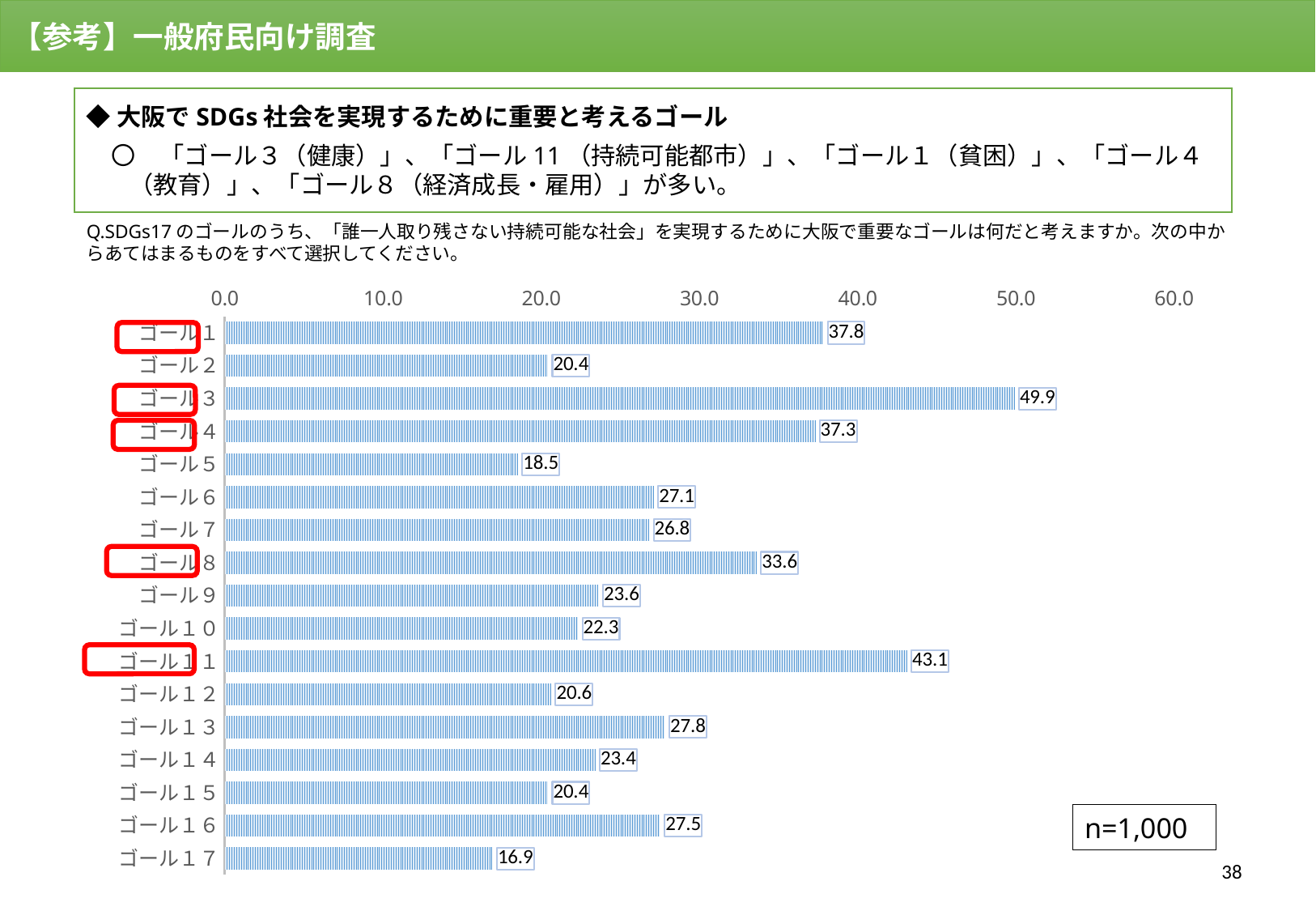
What is the value for ゴール１１? 43.1 Which is larger, the value for ゴール１ or the value for ゴール４? ゴール１ Which goal has the highest value? ゴール３ What is the difference between the values for ゴール１ and ゴール１７? 20.9 Is the value for ゴール８ greater or less than 30.0? greater How many goals (categories) are shown in the chart? 17 What is the value for ゴール３? 49.9 What is the difference between the values for ゴール３ and ゴール１１? 6.8 Which goal has the lowest value? ゴール１７ What is the value for ゴール１７? 16.9 What kind of chart is shown on the slide? bar chart What sample size (n) is shown on the slide? n=1,000